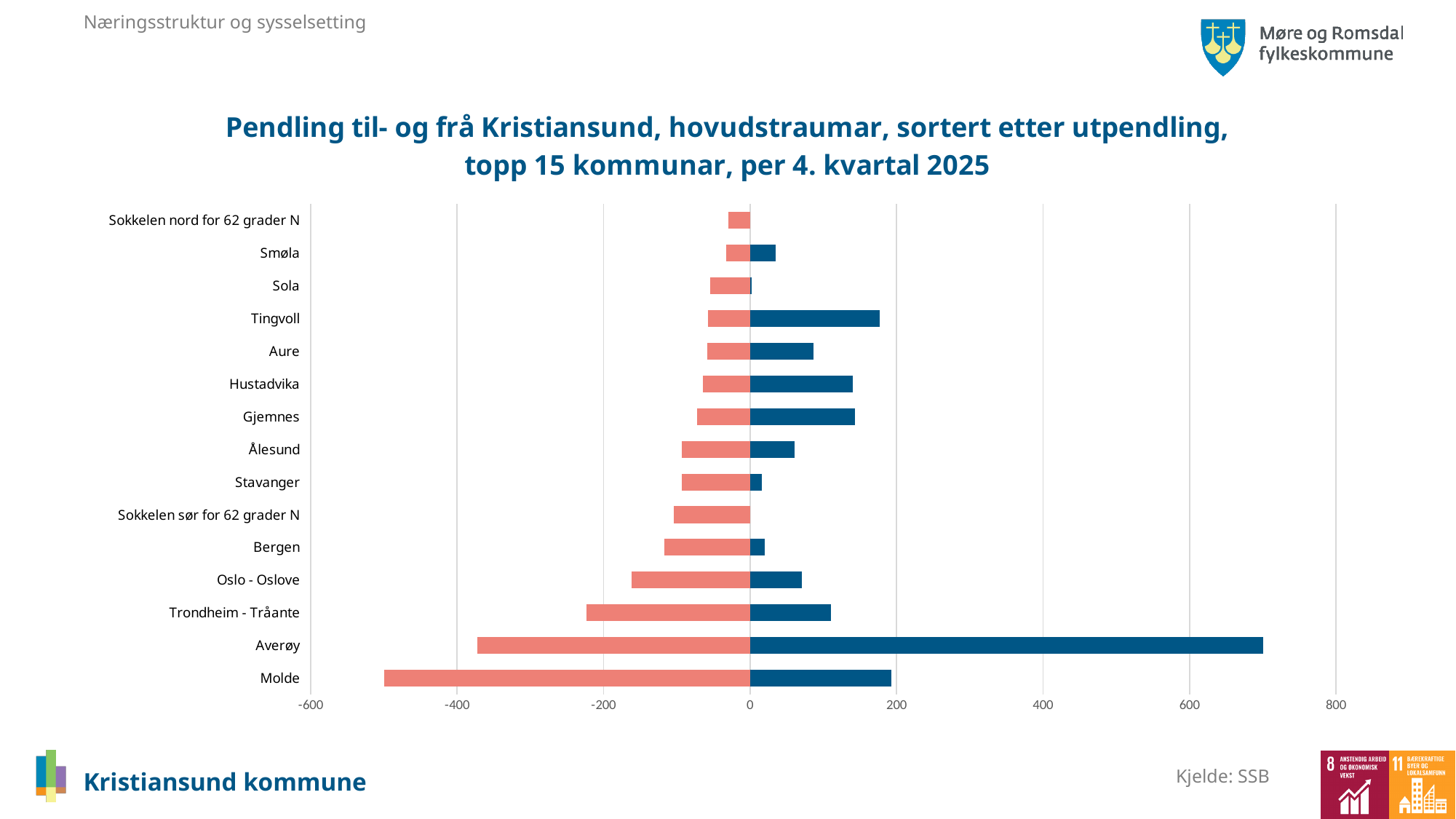
Which municipality is listed at the bottom of the chart? Molde Which municipality has the longest blue (positive) bar? Averøy What kind of chart is shown on the slide? bar chart How many municipalities (categories) are listed on the chart? 15 Is the red bar for Trondheim - Tråante greater or less than -200? less Is the red bar for Molde greater or less than -400? less Which municipality has the longest red (negative) bar? Molde Which has the longer blue bar, Molde or Trondheim - Tråante? Molde Is the blue bar for Averøy greater or less than 600? greater Which has the longer blue bar, Tingvoll or Gjemnes? Tingvoll